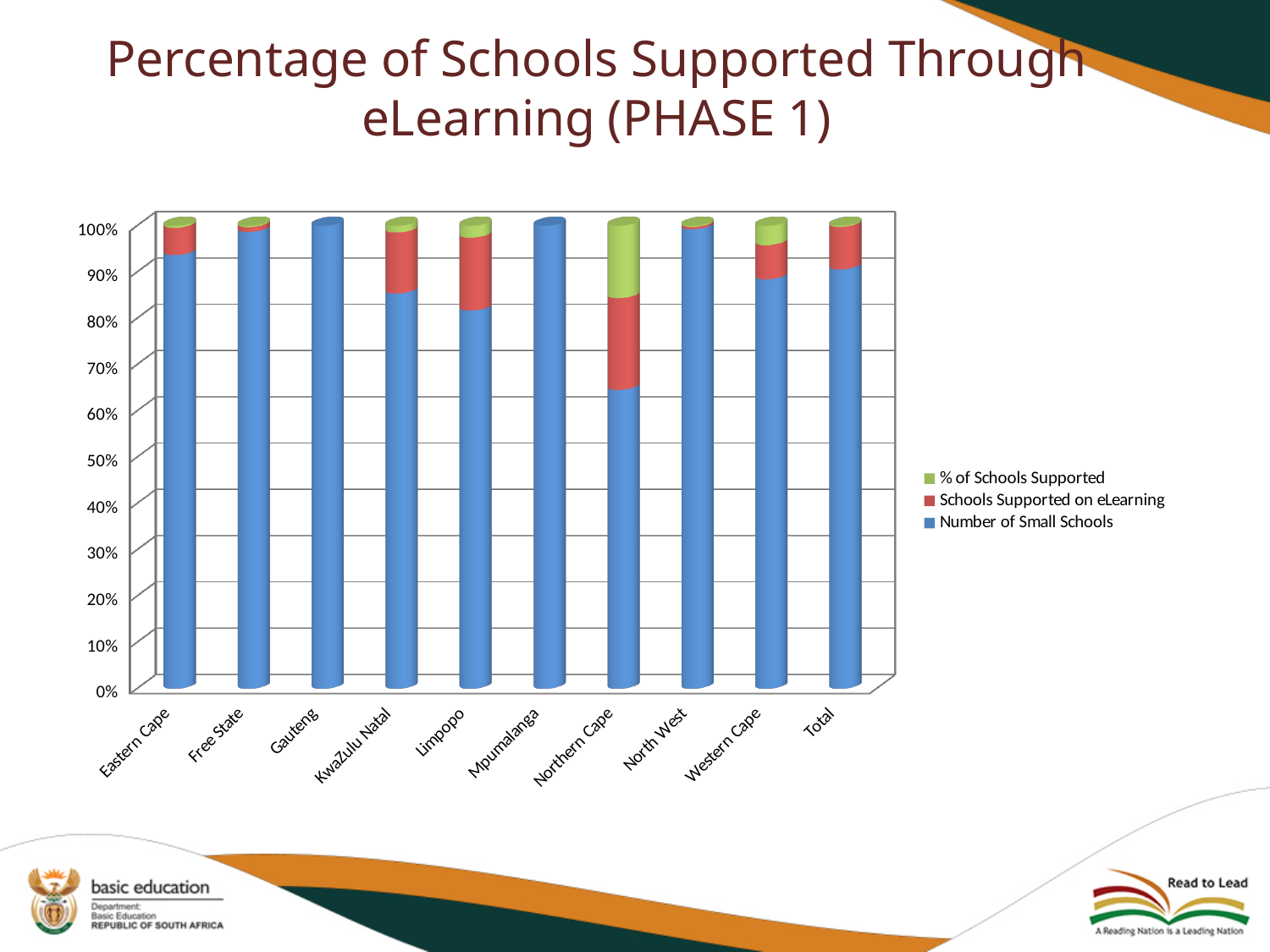
Which category has the smallest share for Number of Small Schools? Northern Cape What does each stacked bar in the chart total? 100% How many categories are shown along the x axis of the chart? 10 Is the Number of Small Schools share for Limpopo greater or less than 90%? less Is the Number of Small Schools share for Northern Cape greater or less than 70%? less Is the Number of Small Schools share for Eastern Cape greater or less than 90%? greater How many series does the chart's legend list? 3 Which series in the legend is shown in green? % of Schools Supported Which category has the largest share for % of Schools Supported? Northern Cape What is the title of the chart on the slide? Percentage of Schools Supported Through eLearning (PHASE 1) Which has a larger Number of Small Schools share, Limpopo or Northern Cape? Limpopo What kind of chart is shown on the slide? Stacked bar chart